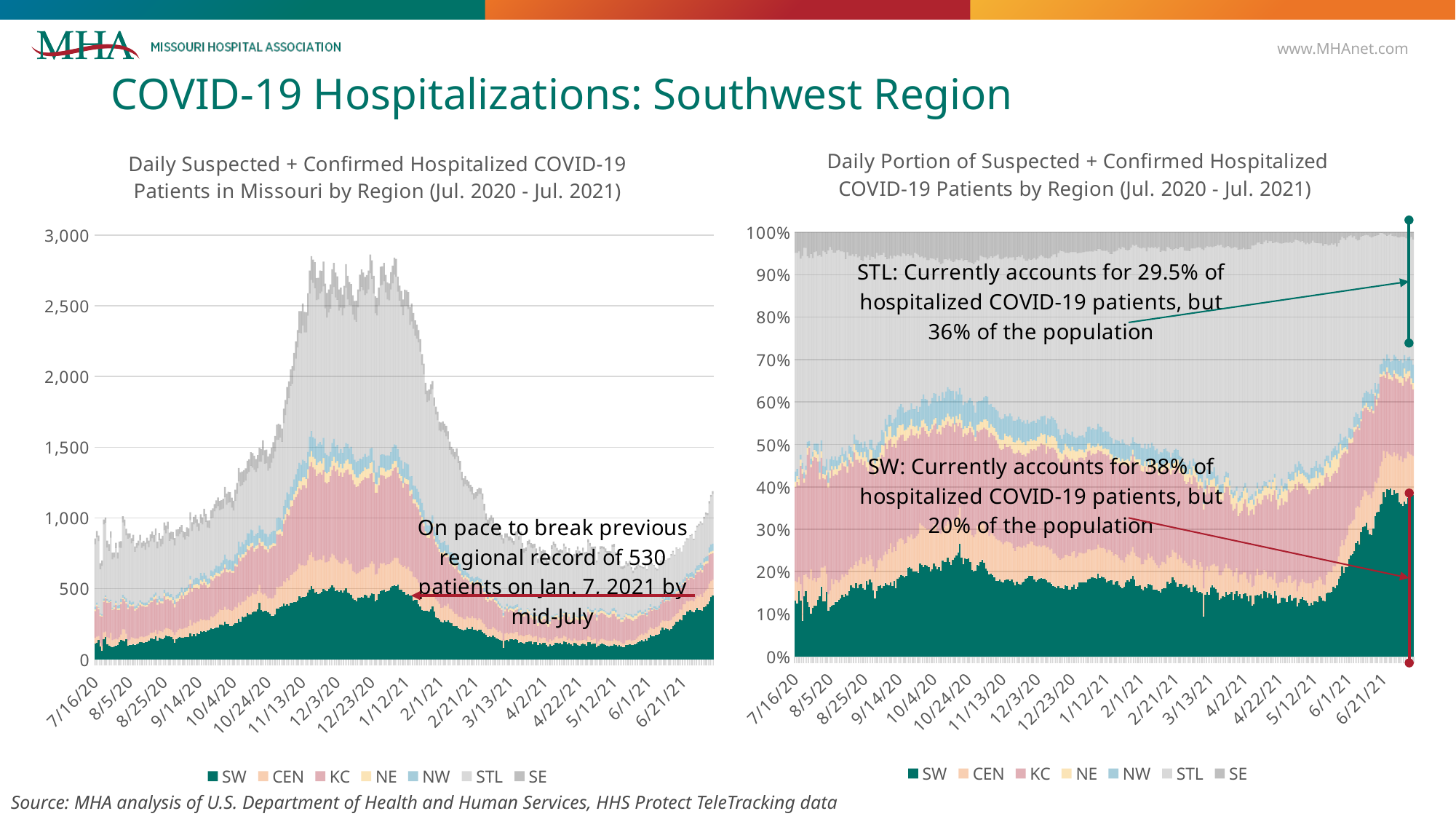
On the right chart, what portion of hospitalized COVID-19 patients does SW currently account for? 38% On the right chart, what share of the population does SW represent according to the annotation? 20% On the left chart, what was the previous regional record number of patients mentioned in the annotation? 530 On the left chart, on what date was the previous regional record of 530 patients set? Jan. 7, 2021 What kind of chart is the left chart, 'Daily Suspected + Confirmed Hospitalized COVID-19 Patients in Missouri by Region'? Stacked area chart On the right chart, what share of the population does STL represent according to the annotation? 36% On the right chart, what is the difference between SW's current share of hospitalized COVID-19 patients (38%) and its share of the population (20%)? 18 percentage points On the right chart, what portion of hospitalized COVID-19 patients does STL currently account for? 29.5% On the right chart, which region currently accounts for a larger portion of hospitalized COVID-19 patients, SW or STL? SW On the left chart, is the peak total of hospitalized patients (around late 2020) greater or less than 2,500? greater On the left chart, how many series does the legend list? 7 On the right chart, how many series does the legend list? 7